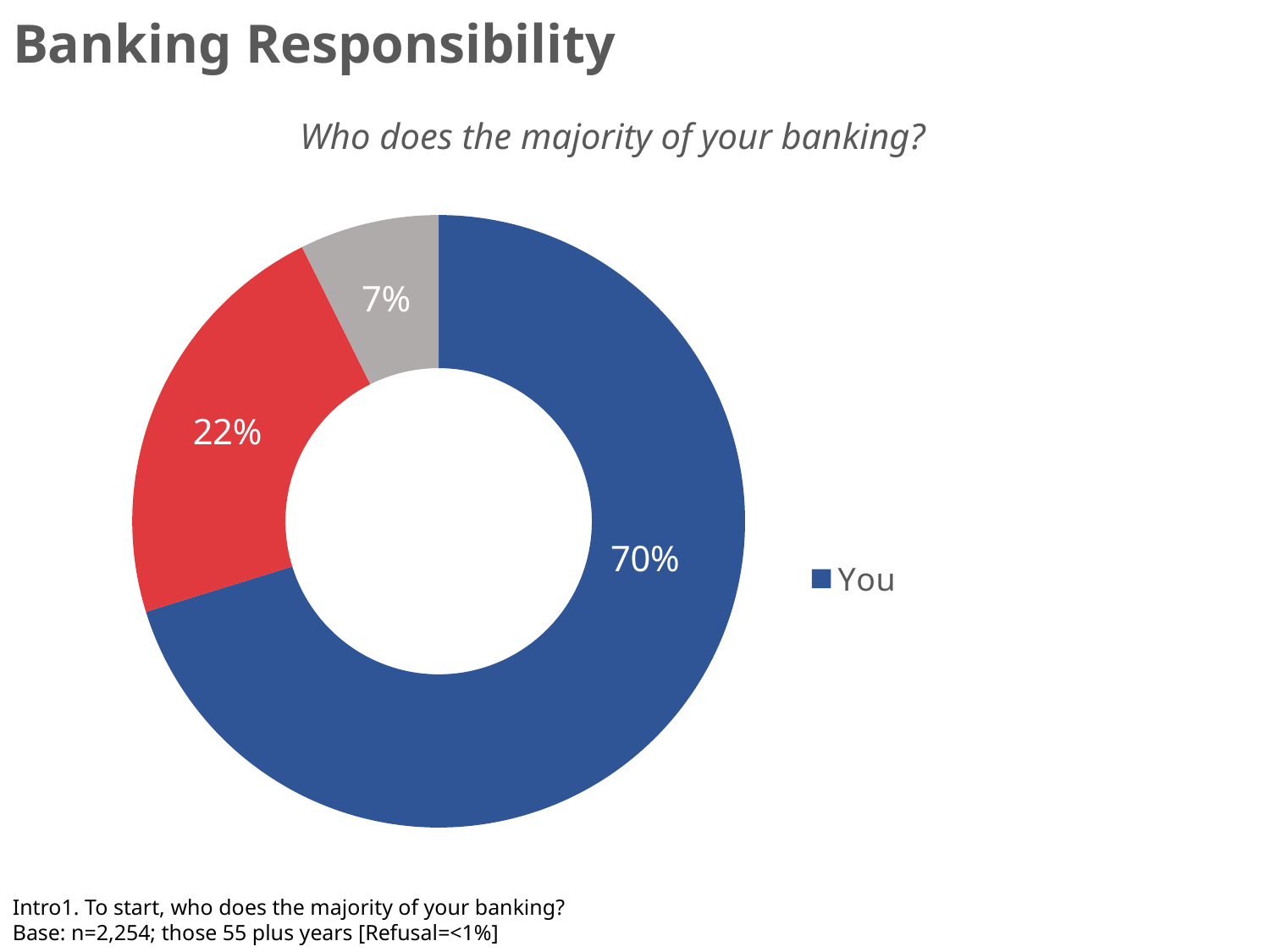
How many slices does the chart have? 3 How many entries does the legend list? 1 What is the difference between the "You" slice and the red slice? 48% Which slice of the chart is the largest? You (70%) What value is shown on the red slice of the chart? 22% What percentage of respondents say they do the majority of their banking themselves (the "You" slice)? 70% What question is the chart titled with? Who does the majority of your banking? What value is shown on the grey slice of the chart? 7% What is the value of the smallest slice in the chart? 7% What kind of chart is shown on the slide? Pie (donut) chart Which is larger, the red slice or the grey slice? The red slice What is the difference between the red slice and the grey slice? 15%